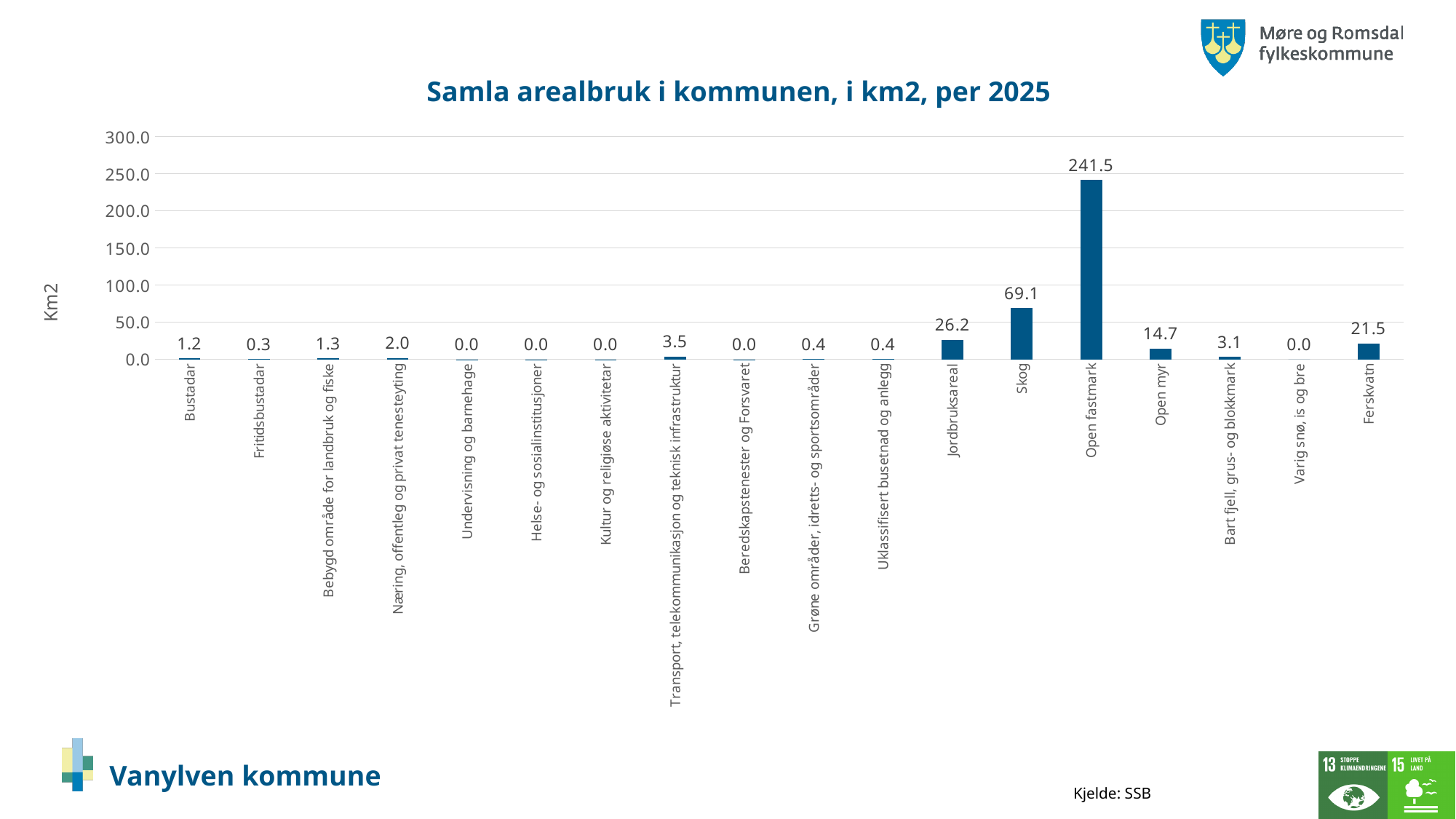
What is the value for Ferskvatn? 21.5 What is the title of the chart? Samla arealbruk i kommunen, i km2, per 2025 What is the value for Open fastmark? 241.5 How many categories are shown on the x axis? 18 What is the difference between the values for Open fastmark and Skog? 172.4 Is the value for Skog greater or less than 50.0? greater What is the value for Transport, telekommunikasjon og teknisk infrastruktur? 3.5 What is the value for Skog? 69.1 What is the value for Jordbruksareal? 26.2 Which is larger, the value for Open myr or the value for Ferskvatn? Ferskvatn Which category has the highest value? Open fastmark What kind of chart is shown? bar chart